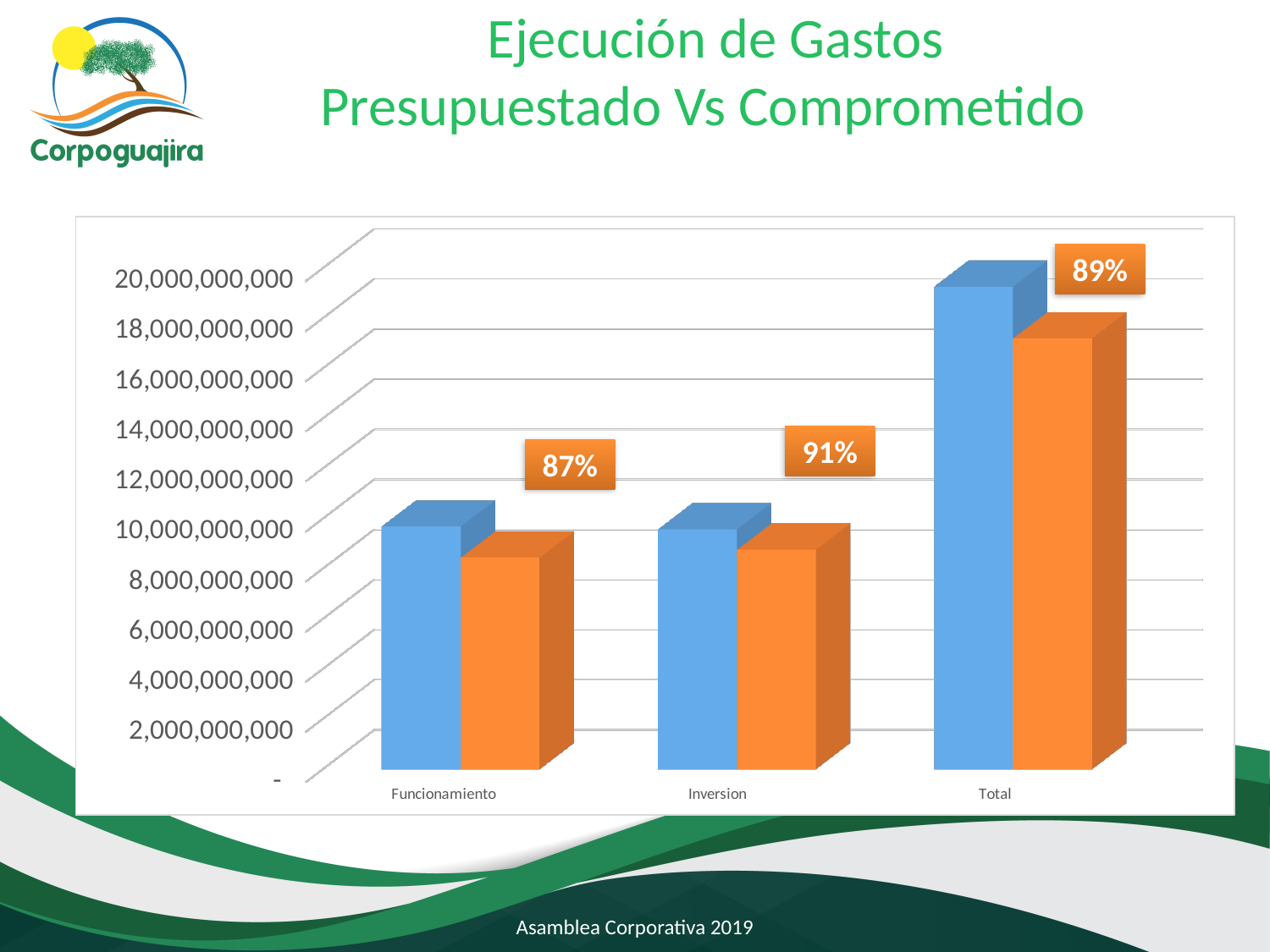
How many categories are shown on the x axis of the chart? 3 What kind of chart is shown on the slide? bar chart Which category has the highest percentage label? Inversion Which category has the tallest bars, Total or Inversion? Total What is the difference in percentage points between the Inversion label and the Funcionamiento label? 4 What percentage label is shown above the Total bars? 89% What percentage label is shown above the Funcionamiento bars? 87% What is the title of the slide containing the chart? Ejecución de Gastos Presupuestado Vs Comprometido Which category has the lowest percentage label? Funcionamiento What percentage label is shown above the Inversion bars? 91% Is the value of the blue bar for Total greater or less than 16,000,000,000? greater Is the value of the blue bar for Funcionamiento greater or less than 12,000,000,000? less